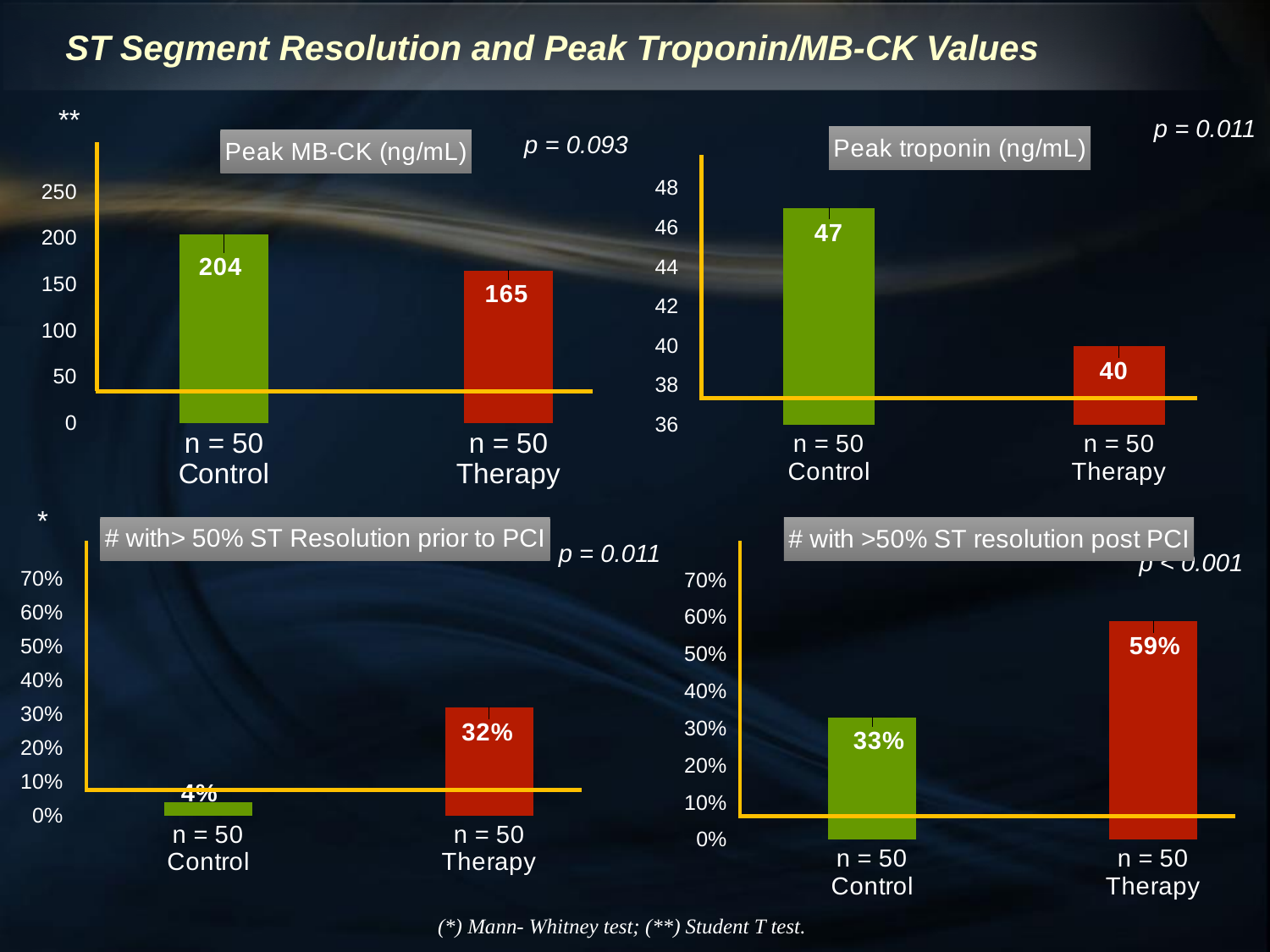
In the '# with >50% ST resolution post PCI' chart, what is the difference between the Therapy and Control values? 26% In the Peak MB-CK (ng/mL) chart, what is the value for the Control group? 204 In the Peak MB-CK (ng/mL) chart, what is the difference between the Control and Therapy values? 39 In the '# with> 50% ST Resolution prior to PCI' chart, which group has the lower value? Control In the '# with >50% ST resolution post PCI' chart, what is the value for the Therapy group? 59% In the Peak troponin (ng/mL) chart, what is the value for the Therapy group? 40 How many charts are shown on the slide? 4 In the '# with> 50% ST Resolution prior to PCI' chart, what is the value for the Therapy group? 32% In the Peak troponin (ng/mL) chart, which group has the higher value? Control In the Peak MB-CK (ng/mL) chart, what is the value for the Therapy group? 165 In the Peak troponin (ng/mL) chart, what is the value for the Control group? 47 What type of chart is the Peak MB-CK (ng/mL) chart? Bar chart